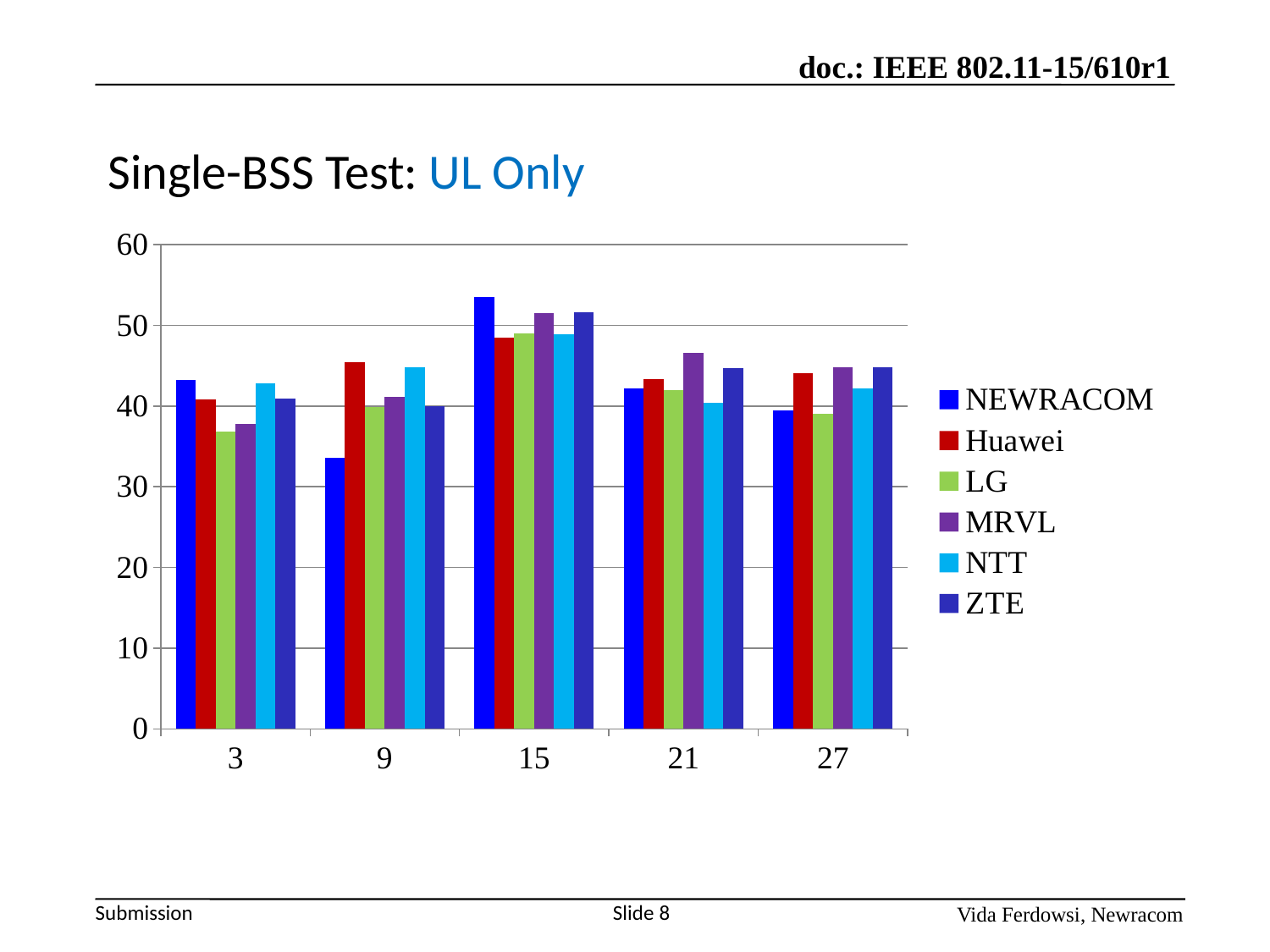
Is the value for NEWRACOM at category 9 greater or less than 40? less Is the value for Huawei at category 9 greater or less than 40? greater What is the title of the slide containing the chart? Single-BSS Test: UL Only What kind of chart is shown on the slide? bar chart At category 9, which is larger: the value for Huawei or the value for NEWRACOM? Huawei Is the value for NEWRACOM at category 15 greater or less than 50? greater How many series does the legend list? 6 How many categories are shown on the x axis? 5 Which series has the lowest value at category 9? NEWRACOM Which series has the highest value at category 15? NEWRACOM Which series is shown in red in the legend? Huawei